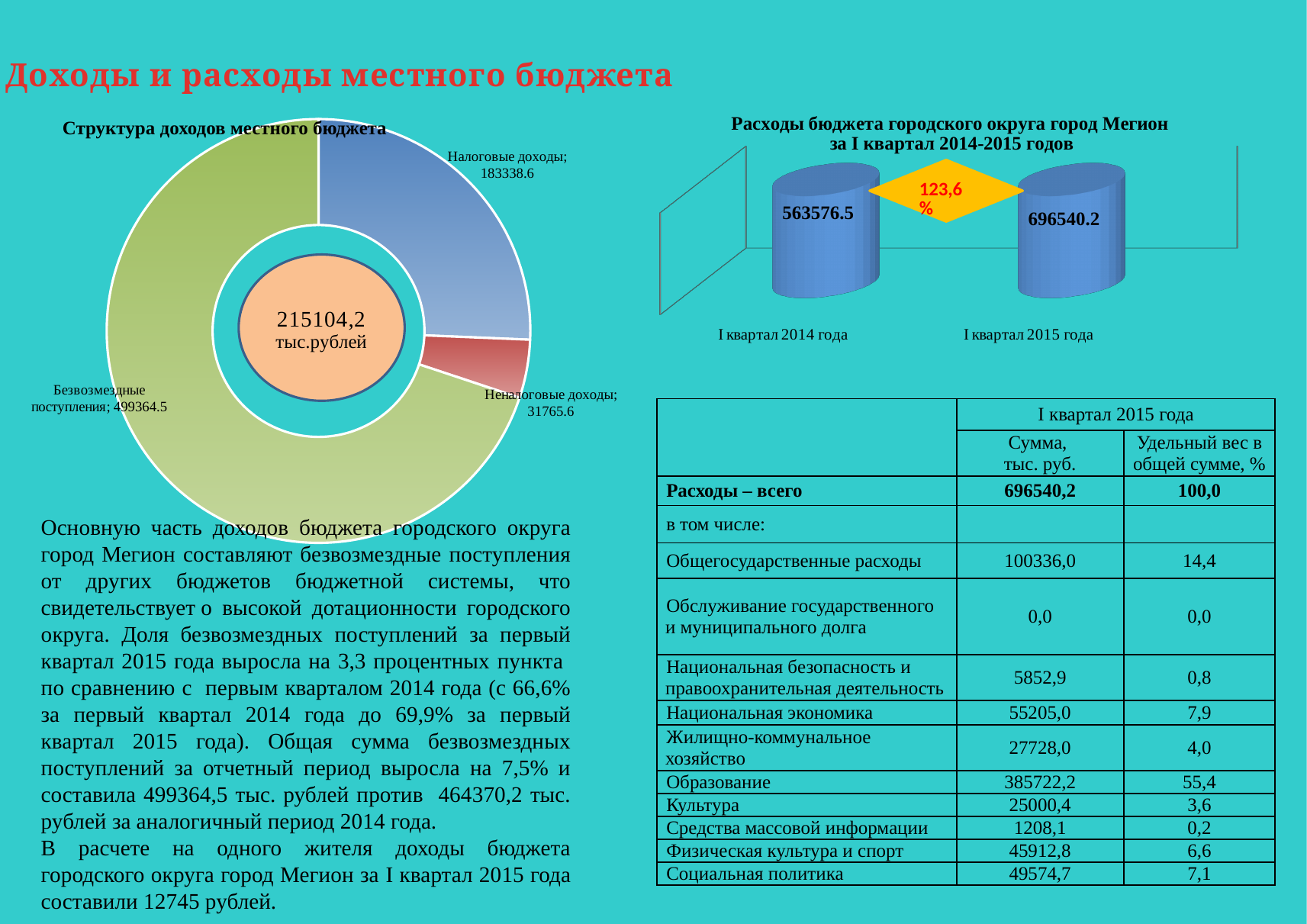
In the chart 'Расходы бюджета городского округа город Мегион за I квартал 2014-2015 годов', what is the value for I квартал 2015 года? 696540.2 In the chart 'Структура доходов местного бюджета', which category has the smallest value? Неналоговые доходы In the chart 'Расходы бюджета городского округа город Мегион за I квартал 2014-2015 годов', what is the difference between I квартал 2015 года and I квартал 2014 года? 132963.7 In the chart 'Структура доходов местного бюджета', what is the value for Неналоговые доходы? 31765.6 What value is printed in the centre of the chart 'Структура доходов местного бюджета'? 215104,2 тыс.рублей In the chart 'Расходы бюджета городского округа город Мегион за I квартал 2014-2015 годов', what is the value for I квартал 2014 года? 563576.5 In the chart 'Структура доходов местного бюджета', what is the value for Безвозмездные поступления? 499364.5 In the chart 'Структура доходов местного бюджета', what is the value for Налоговые доходы? 183338.6 In the chart 'Структура доходов местного бюджета', what is the difference between Безвозмездные поступления and Налоговые доходы? 316025.9 In the chart 'Структура доходов местного бюджета', which category has the largest value? Безвозмездные поступления In the chart 'Расходы бюджета городского округа город Мегион за I квартал 2014-2015 годов', which is larger: I квартал 2014 года or I квартал 2015 года? I квартал 2015 года In the chart 'Структура доходов местного бюджета', how many categories are shown? 3